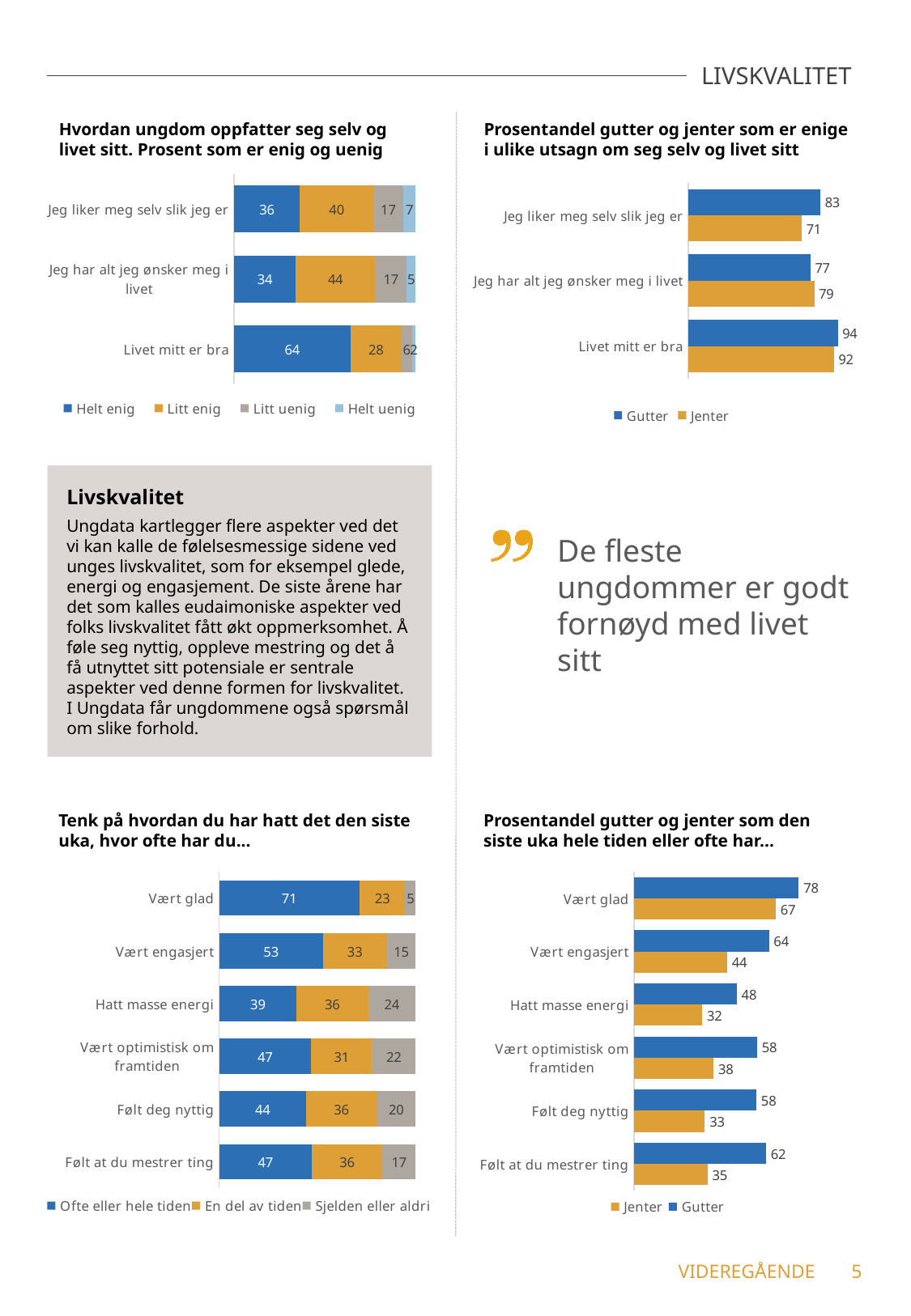
In the bottom-right chart 'Prosentandel gutter og jenter som den siste uka hele tiden eller ofte har…', which is larger for 'Vært engasjert': the 'Gutter' value or the 'Jenter' value? Gutter In the top-right chart 'Prosentandel gutter og jenter som er enige i ulike utsagn om seg selv og livet sitt', what type of chart is shown? Bar chart In the top-right chart 'Prosentandel gutter og jenter som er enige i ulike utsagn om seg selv og livet sitt', which statement has the highest 'Gutter' value? Livet mitt er bra In the bottom-right chart 'Prosentandel gutter og jenter som den siste uka hele tiden eller ofte har…', what is the difference between the 'Gutter' and 'Jenter' values for 'Følt deg nyttig'? 25 In the top-left chart 'Hvordan ungdom oppfatter seg selv og livet sitt', how many series does the legend list? 4 In the top-left chart 'Hvordan ungdom oppfatter seg selv og livet sitt', what is the difference between the 'Litt enig' values for 'Jeg har alt jeg ønsker meg i livet' and 'Jeg liker meg selv slik jeg er'? 4 In the top-right chart 'Prosentandel gutter og jenter som er enige i ulike utsagn om seg selv og livet sitt', what is the 'Jenter' value for 'Jeg liker meg selv slik jeg er'? 71 In the top-left chart 'Hvordan ungdom oppfatter seg selv og livet sitt', what is the 'Helt enig' value for 'Livet mitt er bra'? 64 In the bottom-left chart 'Tenk på hvordan du har hatt det den siste uka, hvor ofte har du…', what is the 'Sjelden eller aldri' value for 'Hatt masse energi'? 24 In the bottom-left chart 'Tenk på hvordan du har hatt det den siste uka, hvor ofte har du…', how many categories are shown? 6 In the bottom-right chart 'Prosentandel gutter og jenter som den siste uka hele tiden eller ofte har…', what is the 'Gutter' value for 'Følt at du mestrer ting'? 62 In the bottom-left chart 'Tenk på hvordan du har hatt det den siste uka, hvor ofte har du…', which category has the lowest 'Ofte eller hele tiden' value? Hatt masse energi